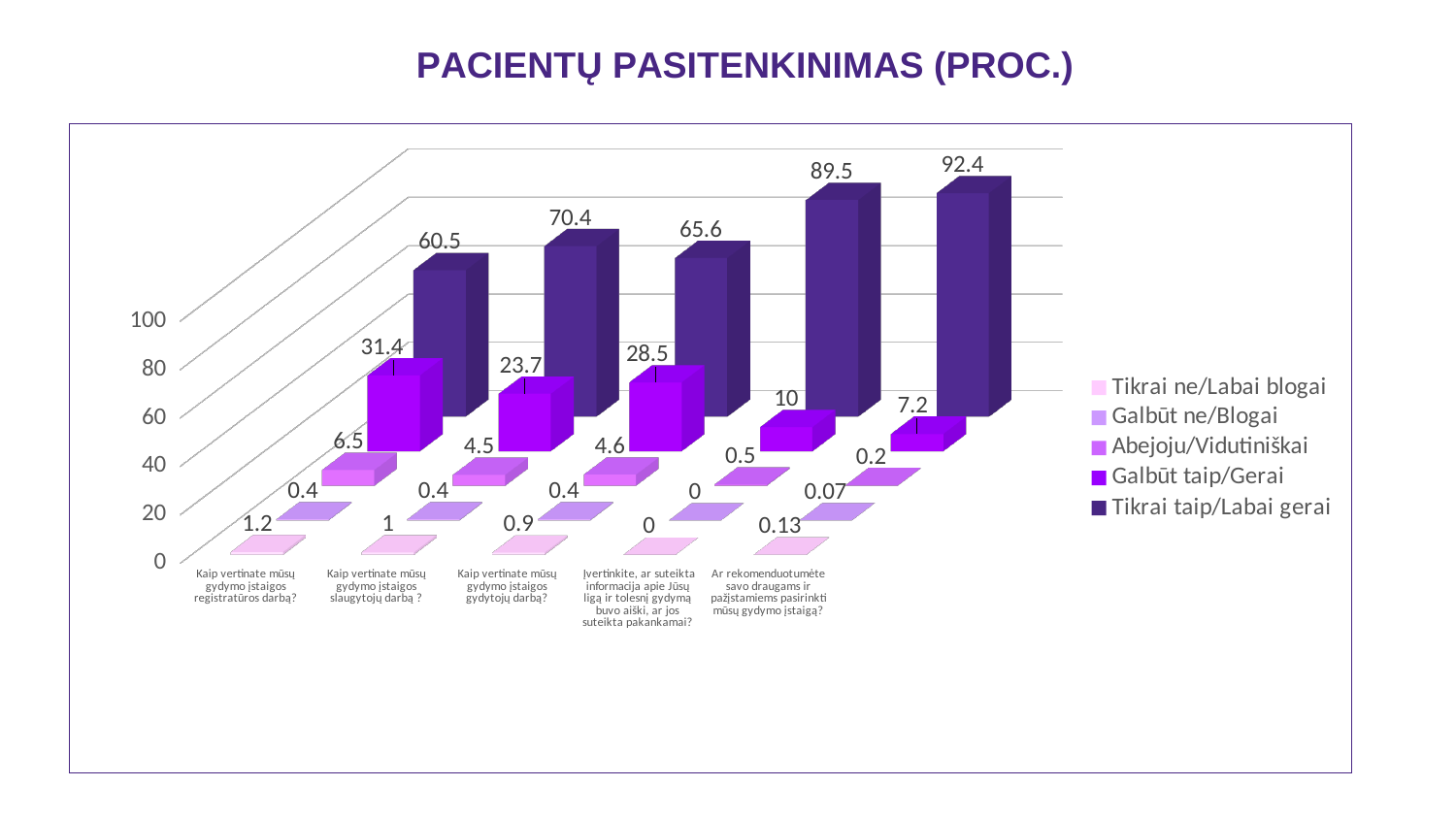
What is the value of "Tikrai taip/Labai gerai" for the category "Ar rekomenduotumėte savo draugams ir pažįstamiems pasirinkti mūsų gydymo įstaigą?"? 92.4 What is the difference between the "Tikrai taip/Labai gerai" values for "Kaip vertinate mūsų gydymo įstaigos slaugytojų darbą ?" and "Kaip vertinate mūsų gydymo įstaigos registratūros darbą?"? 9.9 What is the value of "Galbūt taip/Gerai" for the category "Kaip vertinate mūsų gydymo įstaigos registratūros darbą?"? 31.4 Which category has the lowest value for the "Galbūt taip/Gerai" series? Ar rekomenduotumėte savo draugams ir pažįstamiems pasirinkti mūsų gydymo įstaigą? How many series does the legend list? 5 What is the value of "Abejoju/Vidutiniškai" for the category "Kaip vertinate mūsų gydymo įstaigos slaugytojų darbą ?"? 4.5 What kind of chart is shown on the slide? Bar chart Which category has the highest value for the "Tikrai taip/Labai gerai" series? Ar rekomenduotumėte savo draugams ir pažįstamiems pasirinkti mūsų gydymo įstaigą? Which is larger: the "Galbūt taip/Gerai" value for "Kaip vertinate mūsų gydymo įstaigos gydytojų darbą?" or for "Kaip vertinate mūsų gydymo įstaigos slaugytojų darbą ?"? Kaip vertinate mūsų gydymo įstaigos gydytojų darbą? What is the title of the chart? PACIENTŲ PASITENKINIMAS (PROC.) What is the value of "Tikrai ne/Labai blogai" for the category "Kaip vertinate mūsų gydymo įstaigos gydytojų darbą?"? 0.9 How many categories are shown on the x axis of the chart? 5